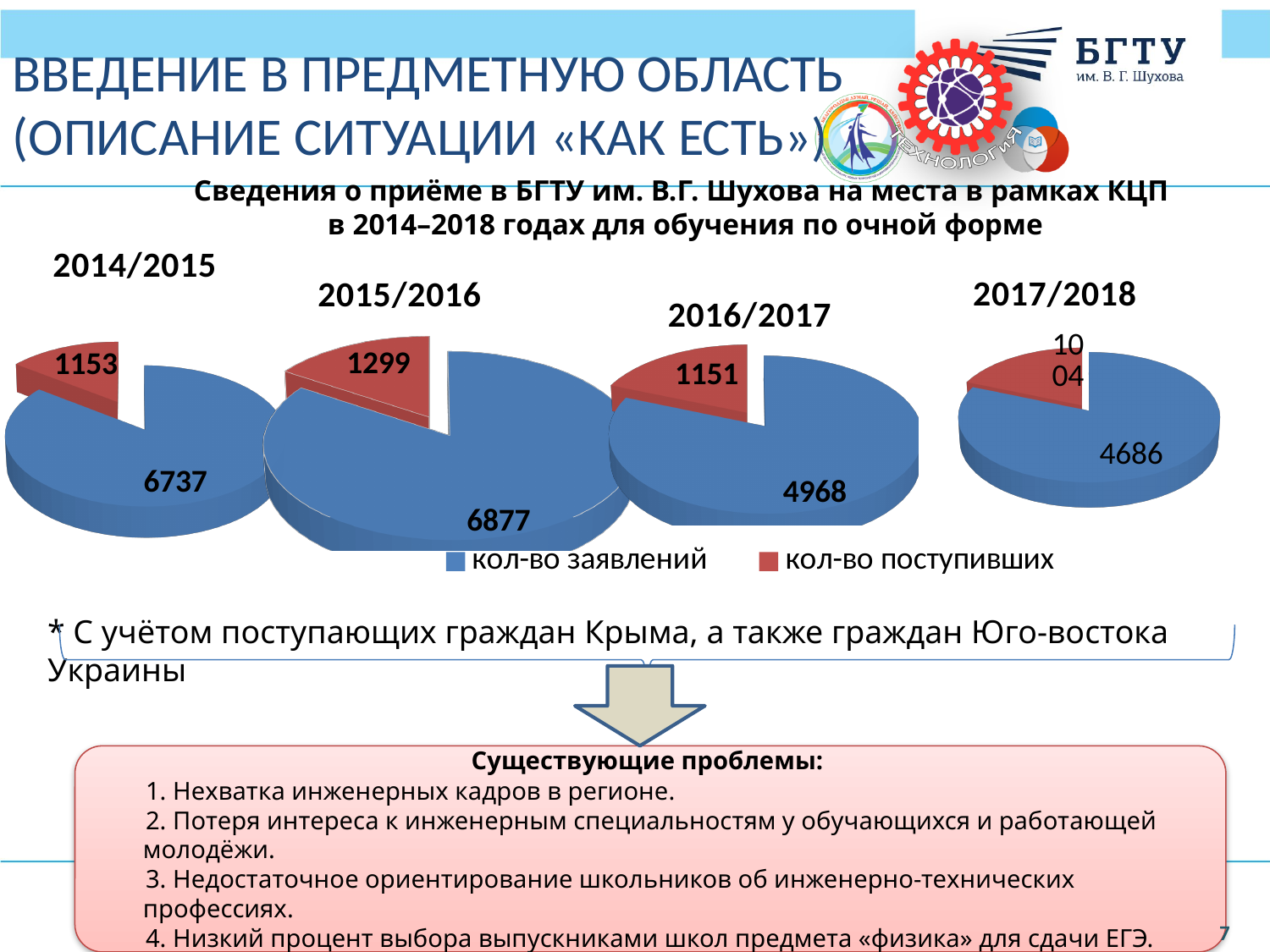
In the 2017/2018 pie chart, what is the value for кол-во заявлений? 4686 In the 2014/2015 pie chart, what is the value for кол-во заявлений? 6737 How many pie charts are shown on the slide? 4 In the 2015/2016 pie chart, what is the value for кол-во поступивших? 1299 In the 2016/2017 pie chart, what is the value for кол-во заявлений? 4968 Across the four pie charts, which academic year has the highest number of кол-во заявлений? 2015/2016 What is the total of the two slices in the 2016/2017 pie chart? 6119 What kind of chart is used to show the admission data on this slide? Pie chart In the 2014/2015 pie chart, what is the difference between кол-во заявлений and кол-во поступивших? 5584 Which is larger: кол-во поступивших in the 2015/2016 chart or in the 2016/2017 chart? 2015/2016 How many series does the legend below the charts list? 2 Across the four pie charts, which academic year has the lowest number of кол-во заявлений? 2017/2018